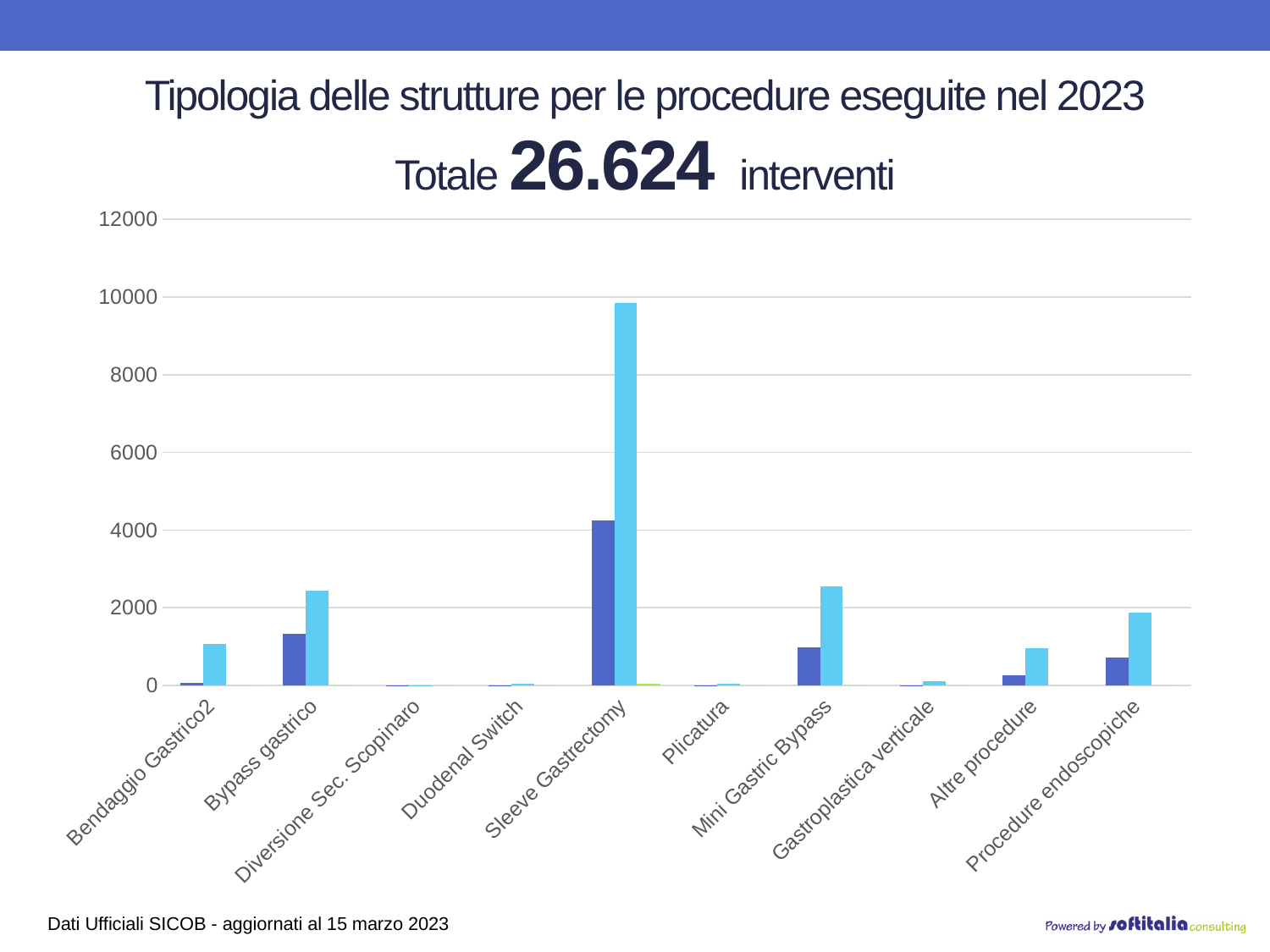
Which category has the tallest bar in the chart? Sleeve Gastrectomy Is the light blue bar for Bendaggio Gastrico2 greater or less than 2000? less Is the light blue bar for Bypass gastrico greater or less than 2000? greater Is the light blue bar for Sleeve Gastrectomy greater or less than 8000? greater Which has the larger light blue bar, Mini Gastric Bypass or Altre procedure? Mini Gastric Bypass What kind of chart is shown on the slide? bar chart How many procedure categories are shown on the x axis? 10 What total number of interventi is stated above the chart? 26.624 Which has the larger light blue bar, Bypass gastrico or Procedure endoscopiche? Bypass gastrico